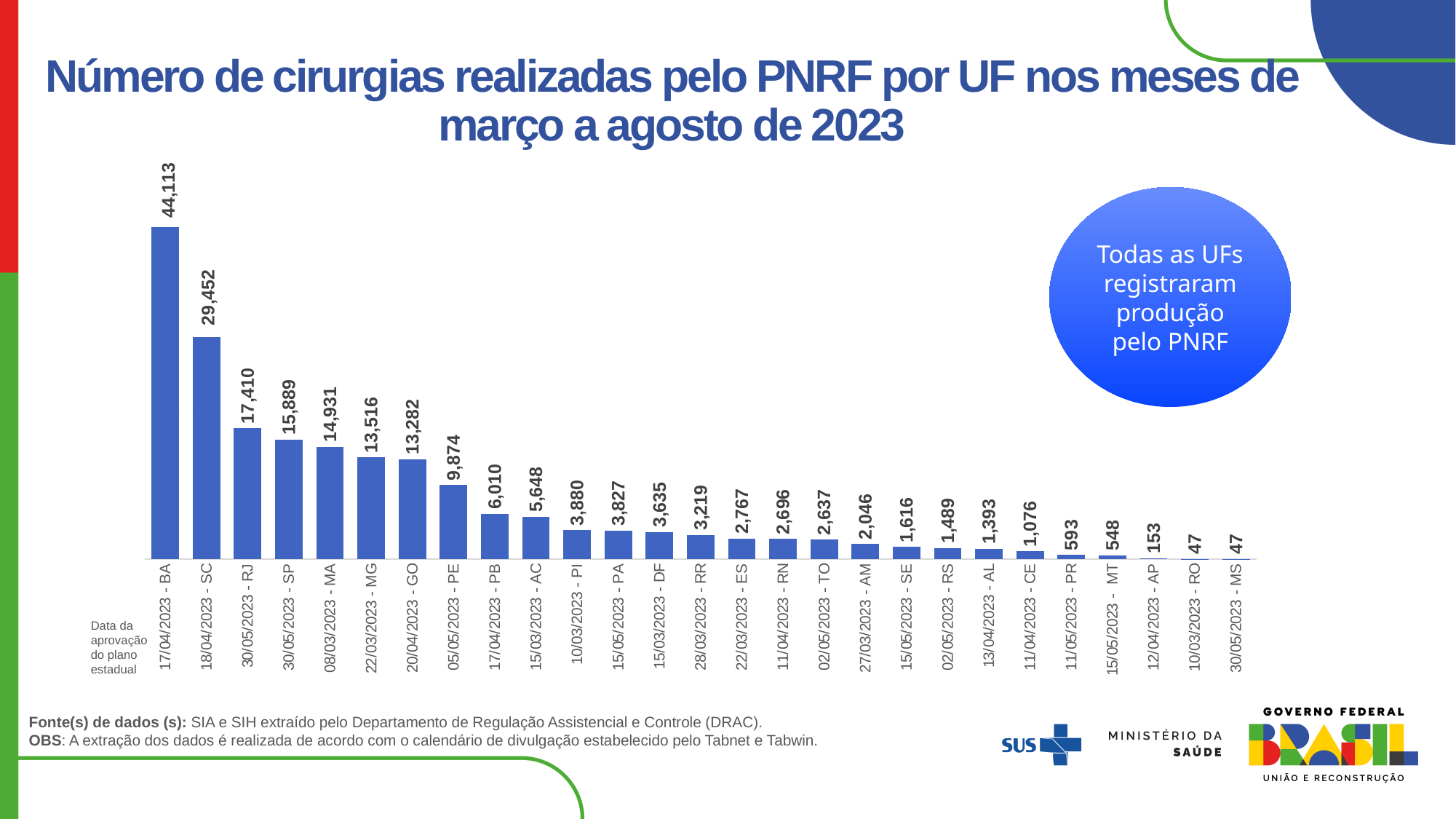
What is the number of surgeries shown for PE (05/05/2023)? 9,874 What kind of chart is shown on the slide? Bar chart Which has a larger value, PR or MT? PR What is the number of surgeries shown for BA (17/04/2023)? 44,113 Which UF has the highest number of surgeries in the chart? BA What is the title of the chart on the slide? Número de cirurgias realizadas pelo PNRF por UF nos meses de março a agosto de 2023 What is the number of surgeries shown for SC (18/04/2023)? 29,452 What is the difference between the values for BA and SC? 14,661 Which has a larger value, MG or GO? MG What is the difference between the values for RJ and SP? 1,521 What is the number of surgeries shown for AP (12/04/2023)? 153 How many UFs (bars) are shown in the chart? 27